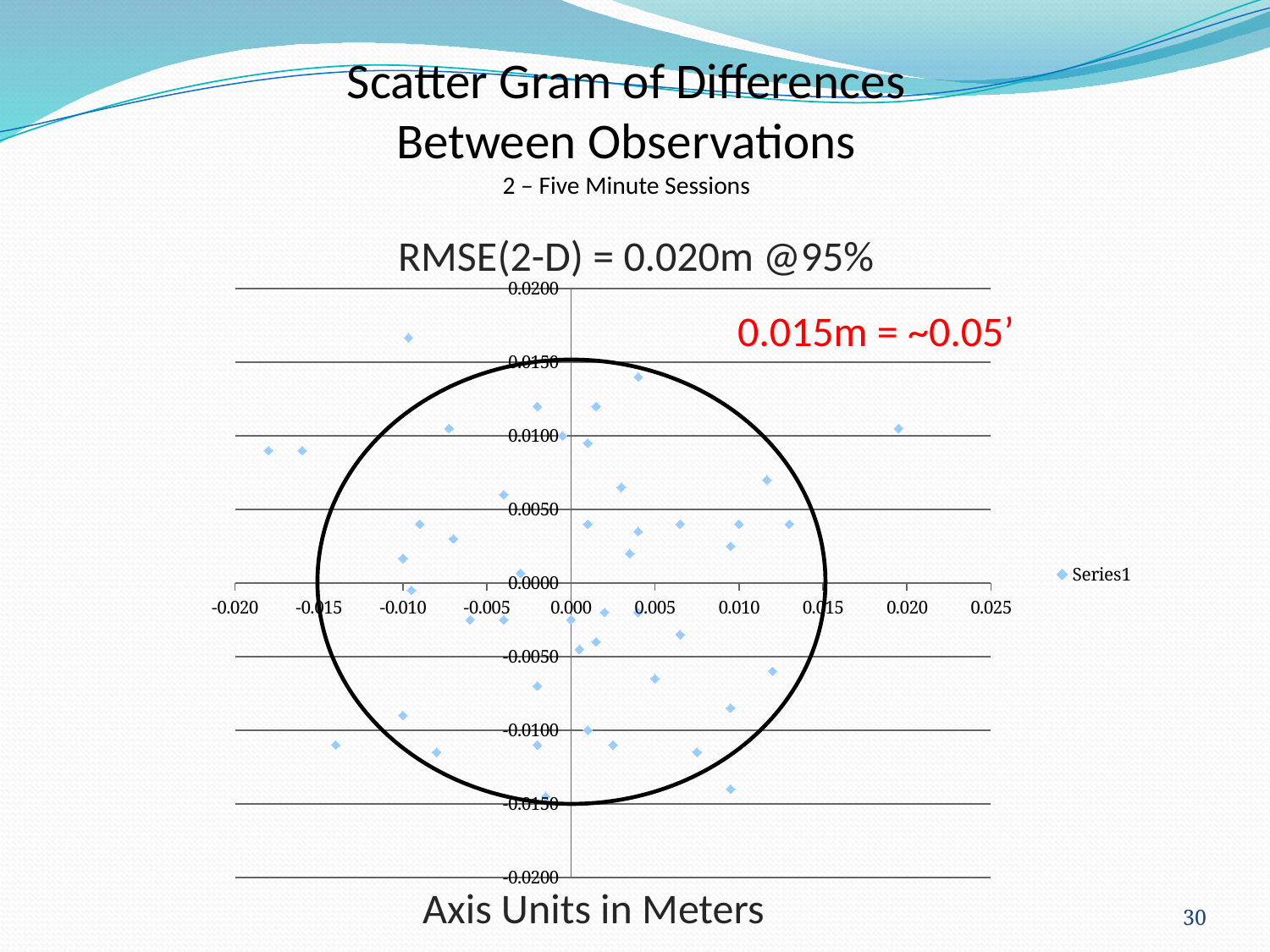
Is the x value of the leftmost plotted point greater or less than -0.015? less What is the name of the series shown in the chart legend? Series1 Is the y value of the lowest plotted point greater or less than -0.0100? less Is the x value of the rightmost plotted point greater or less than 0.015? greater How many series does the chart legend list? 1 What is the title of the chart? RMSE(2-D) = 0.020m @95% What kind of chart is shown on the slide? scatter chart